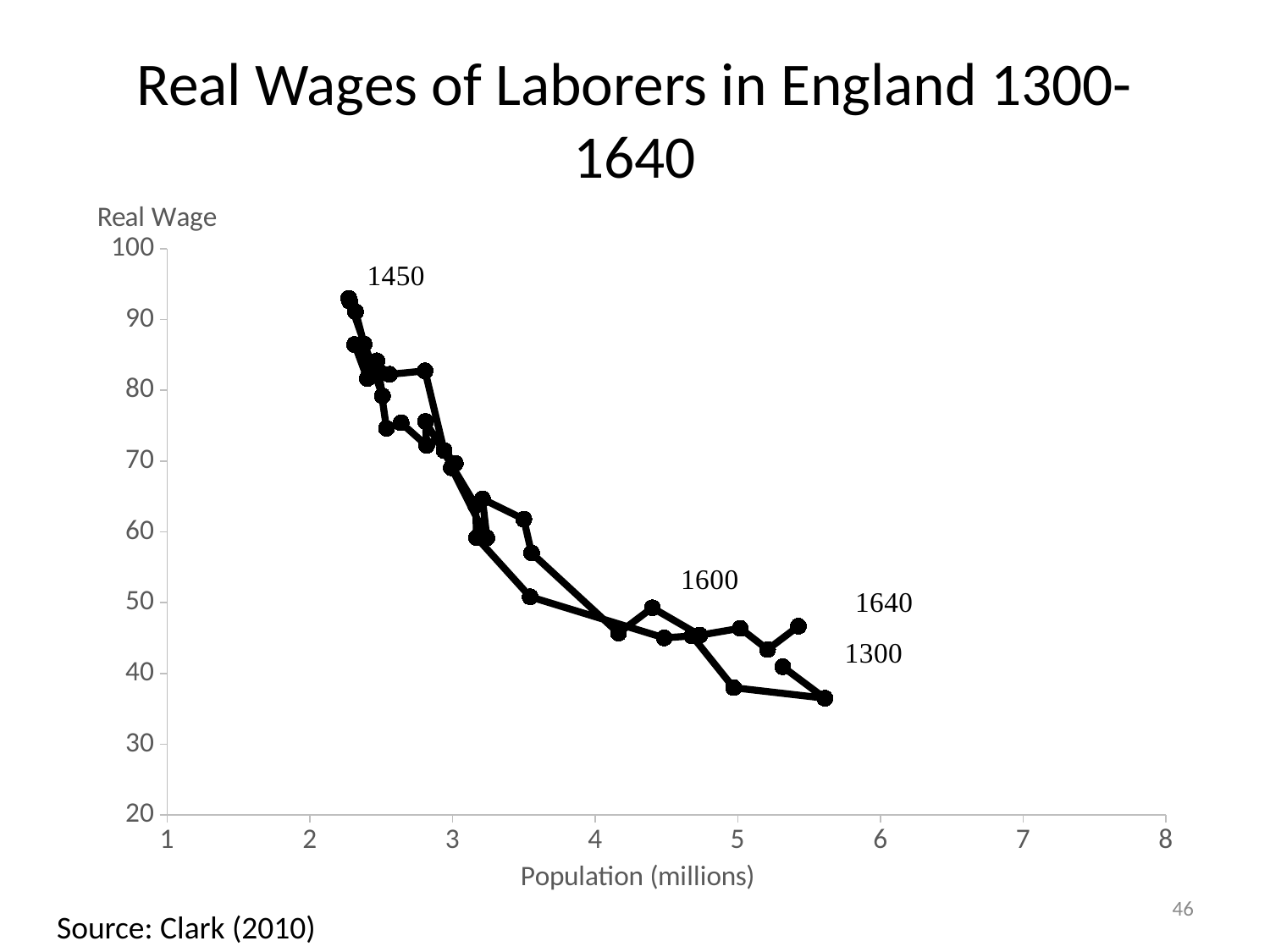
What is the label of the horizontal axis? Population (millions) Is the real wage at the point labeled 1450 greater or less than 90? greater Which labeled year has the highest real wage? 1450 Which has the higher real wage, the point labeled 1450 or the point labeled 1600? 1450 Is the real wage at the point labeled 1300 greater or less than 40? less Is the real wage at the point labeled 1640 greater or less than 50? less Which labeled year has the lowest real wage? 1300 What kind of chart is shown on the slide? scatter chart What is the title of the chart? Real Wages of Laborers in England 1300-1640 As population increases along the x axis, do real wages generally rise or fall? fall